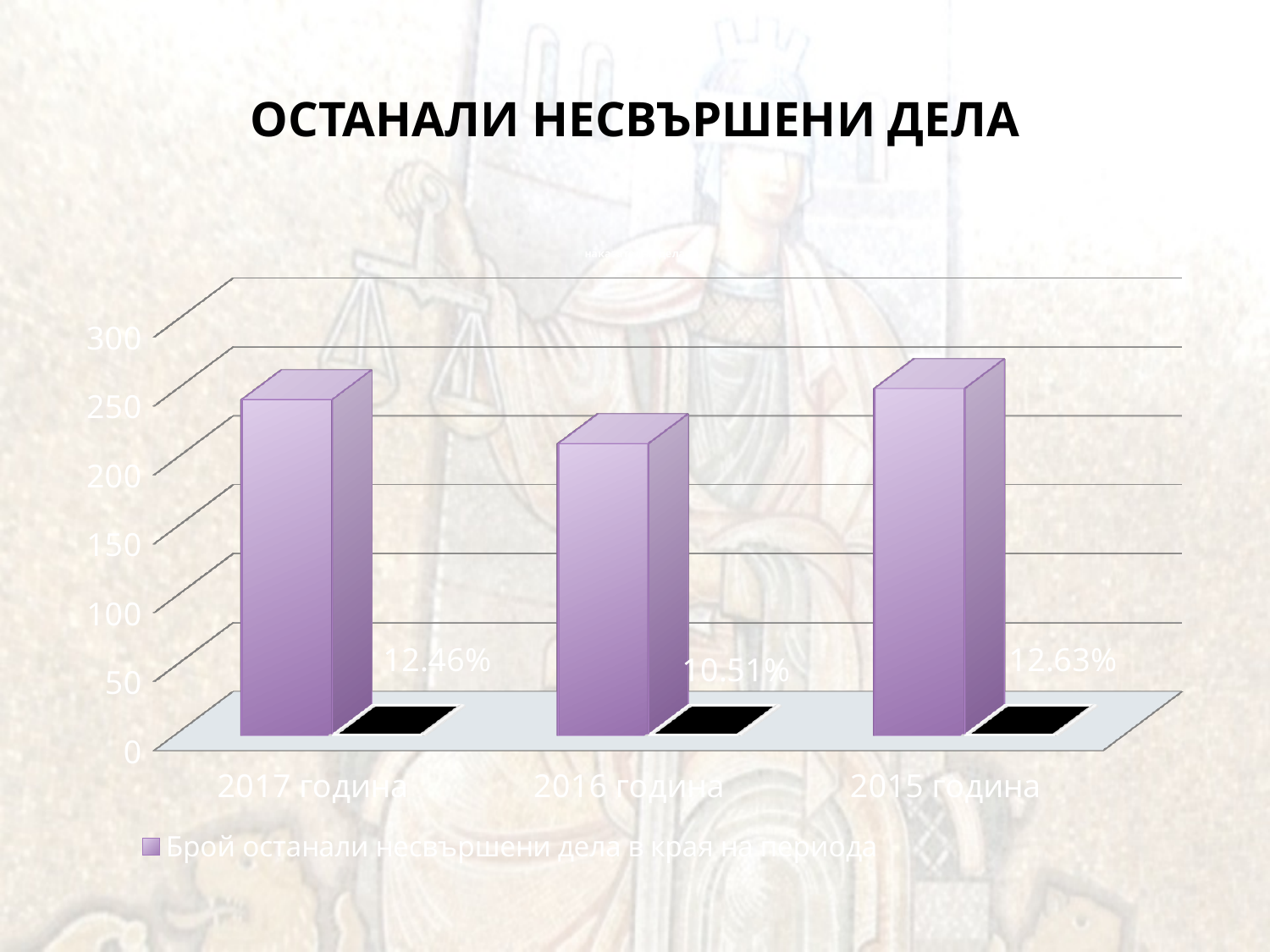
How many series does the chart legend list? 1 Which year has the lowest bar in the chart? 2016 година Which year has the highest percentage label in the chart? 2015 година Is the value for 2015 година greater or less than 200? greater How many categories (years) are shown on the x axis of the chart? 3 What percentage label is printed for 2016 година? 10.51% What percentage label is printed for 2017 година? 12.46% Is the value for 2016 година greater or less than 250? less What kind of chart is shown on the slide? bar chart What percentage label is printed for 2015 година? 12.63% Which bar is taller, 2017 година or 2016 година? 2017 година